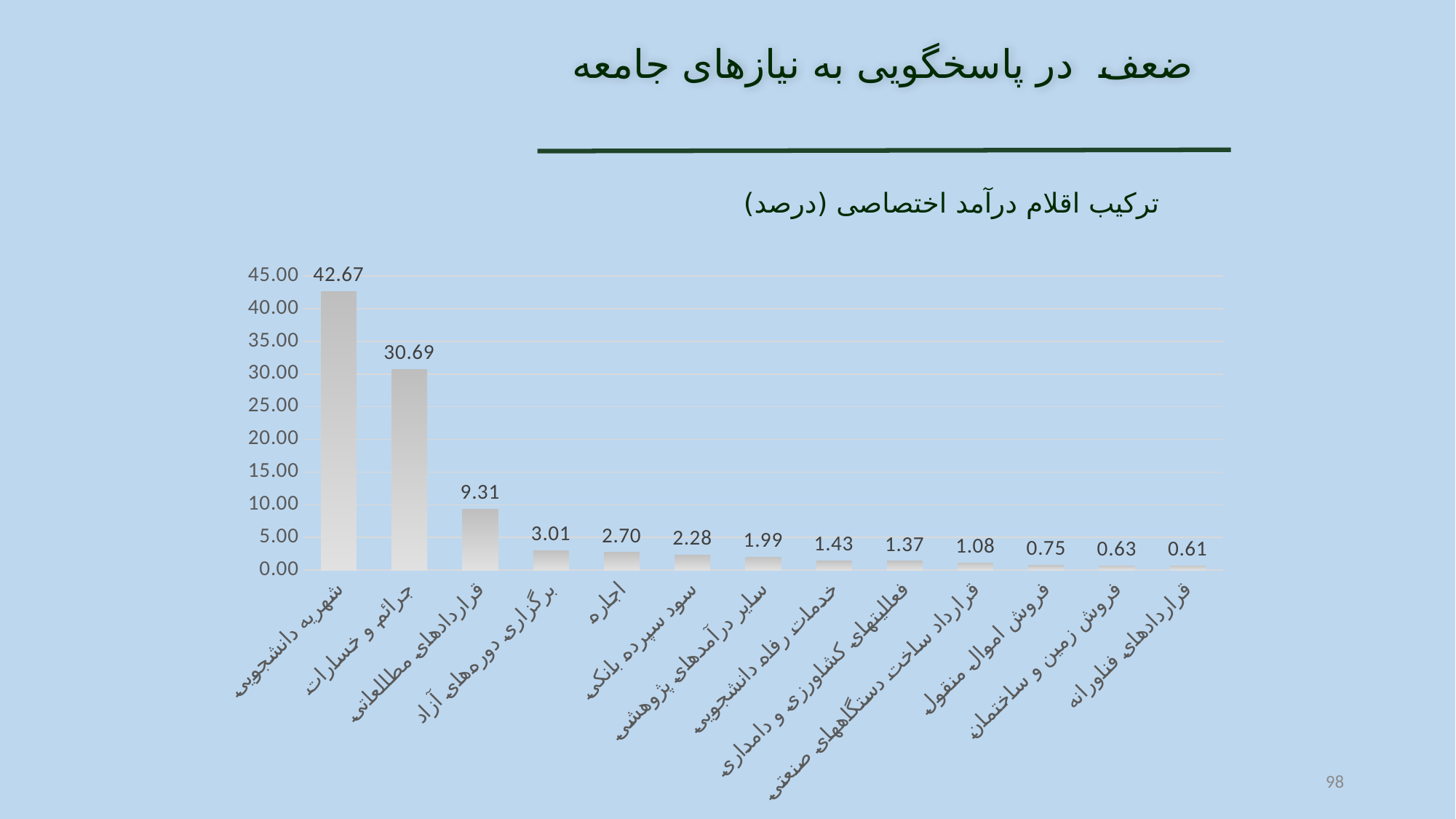
What kind of chart is shown on the slide? Bar chart What is the value for اجاره? 2.70 Which is larger, the value for سود سپرده بانکی or the value for خدمات رفاه دانشجویی? سود سپرده بانکی What is the difference between the values for شهریه دانشجویی and جرائم و خسارات? 11.98 What is the title of the chart? ترکیب اقلام درآمد اختصاصی (درصد) What is the value for قراردادهای فناورانه? 0.61 How many categories are shown in the chart? 13 What is the value for شهریه دانشجویی? 42.67 Which category has the lowest value? قراردادهای فناورانه What is the value for قراردادهای مطالعاتی? 9.31 What is the value for جرائم و خسارات? 30.69 Which category has the highest value? شهریه دانشجویی